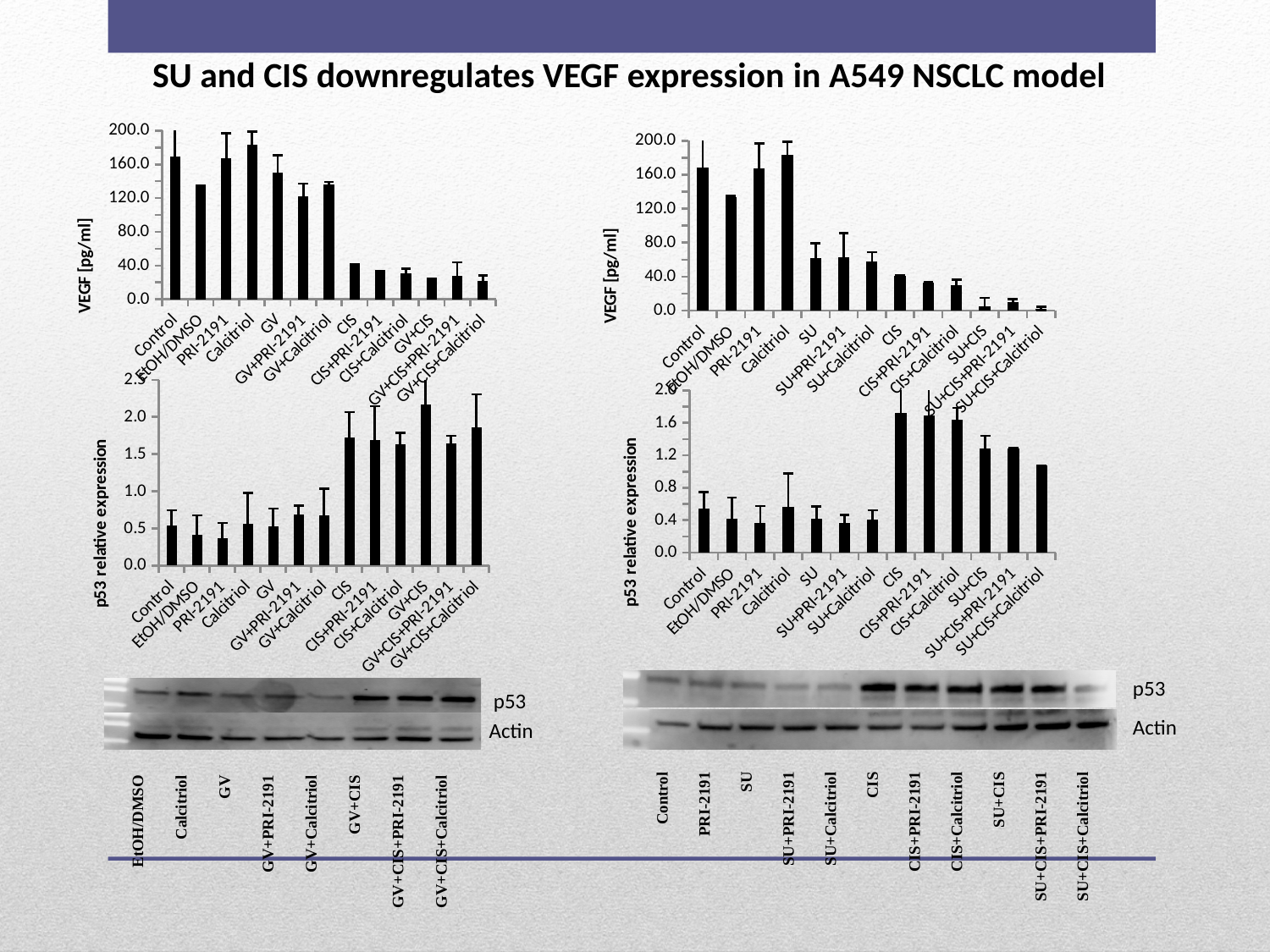
What is the y-axis label of the bottom-right chart? p53 relative expression In the top-right VEGF chart, which category has the lowest bar? SU+CIS+Calcitriol In the top-left VEGF chart, is the value for Control greater or less than 120.0? greater In the top-right VEGF chart, how many categories are shown on the x axis? 13 In the bottom-left p53 relative expression chart, which is larger, the value for CIS or the value for Control? CIS What kind of chart is the top-left chart (VEGF [pg/ml])? bar chart In the top-right VEGF chart, which category has the highest bar? Calcitriol In the bottom-right p53 relative expression chart, is the value for Control greater or less than 0.8? less In the top-right VEGF chart, which is larger, the value for SU or the value for Calcitriol? Calcitriol In the bottom-right p53 relative expression chart, is the value for CIS greater or less than 1.2? greater What is the y-axis label of the top-left chart? VEGF [pg/ml]